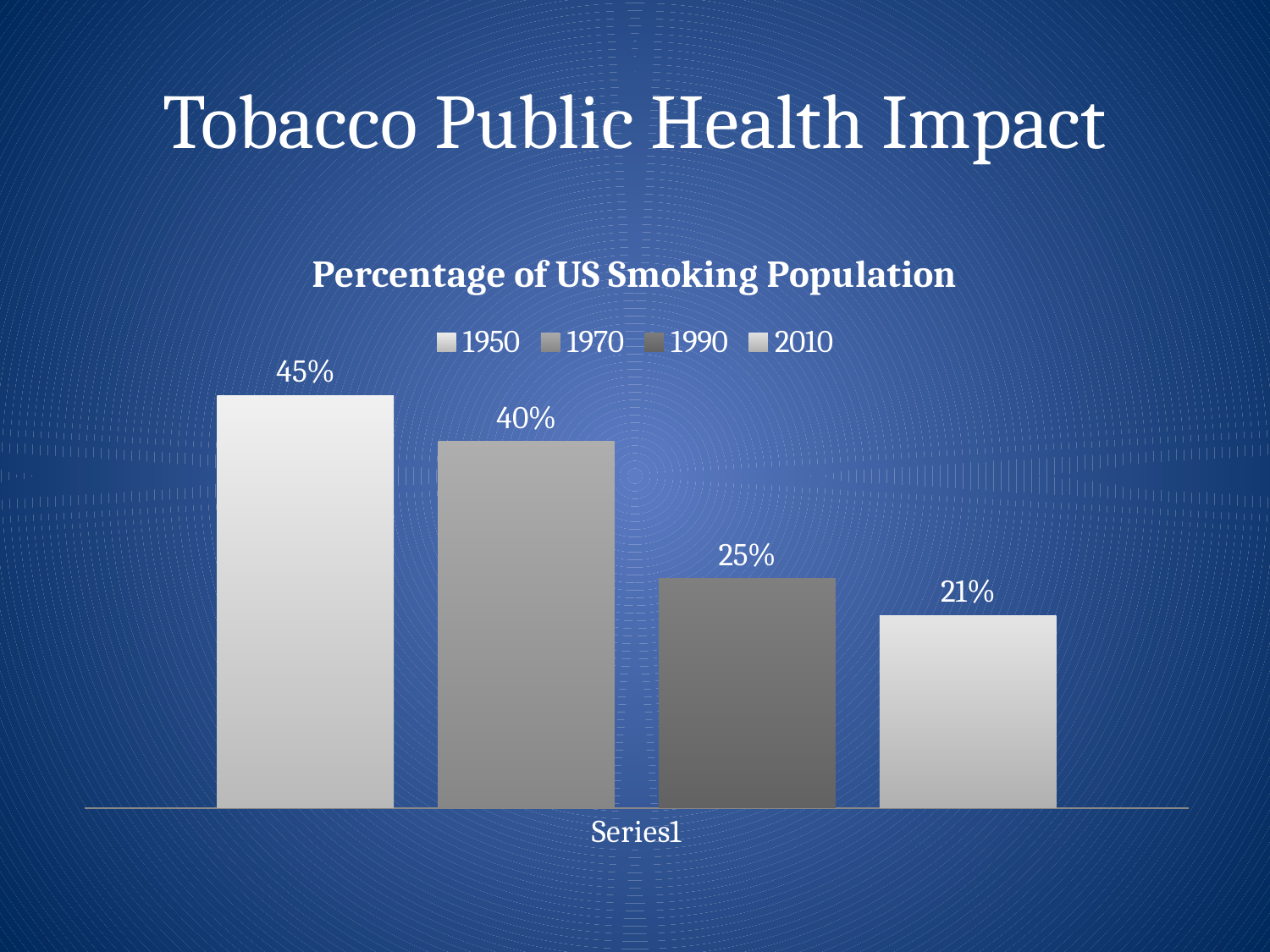
What is the value for 1990 in the Percentage of US Smoking Population chart? 25% What is the value for 1950 in the Percentage of US Smoking Population chart? 45% How many series does the legend list? 4 Do the values rise or fall from 1950 to 2010? Fall What is the value for 2010 in the Percentage of US Smoking Population chart? 21% What kind of chart is shown on the slide? Bar chart What is the difference between the 1950 and 2010 values? 24% What is the difference between the 1970 and 1990 values? 15% Which year has the highest percentage of US smoking population? 1950 Which year has the lowest percentage of US smoking population? 2010 Which is larger, the value for 1970 or the value for 1990? 1970 What is the value for 1970 in the Percentage of US Smoking Population chart? 40%